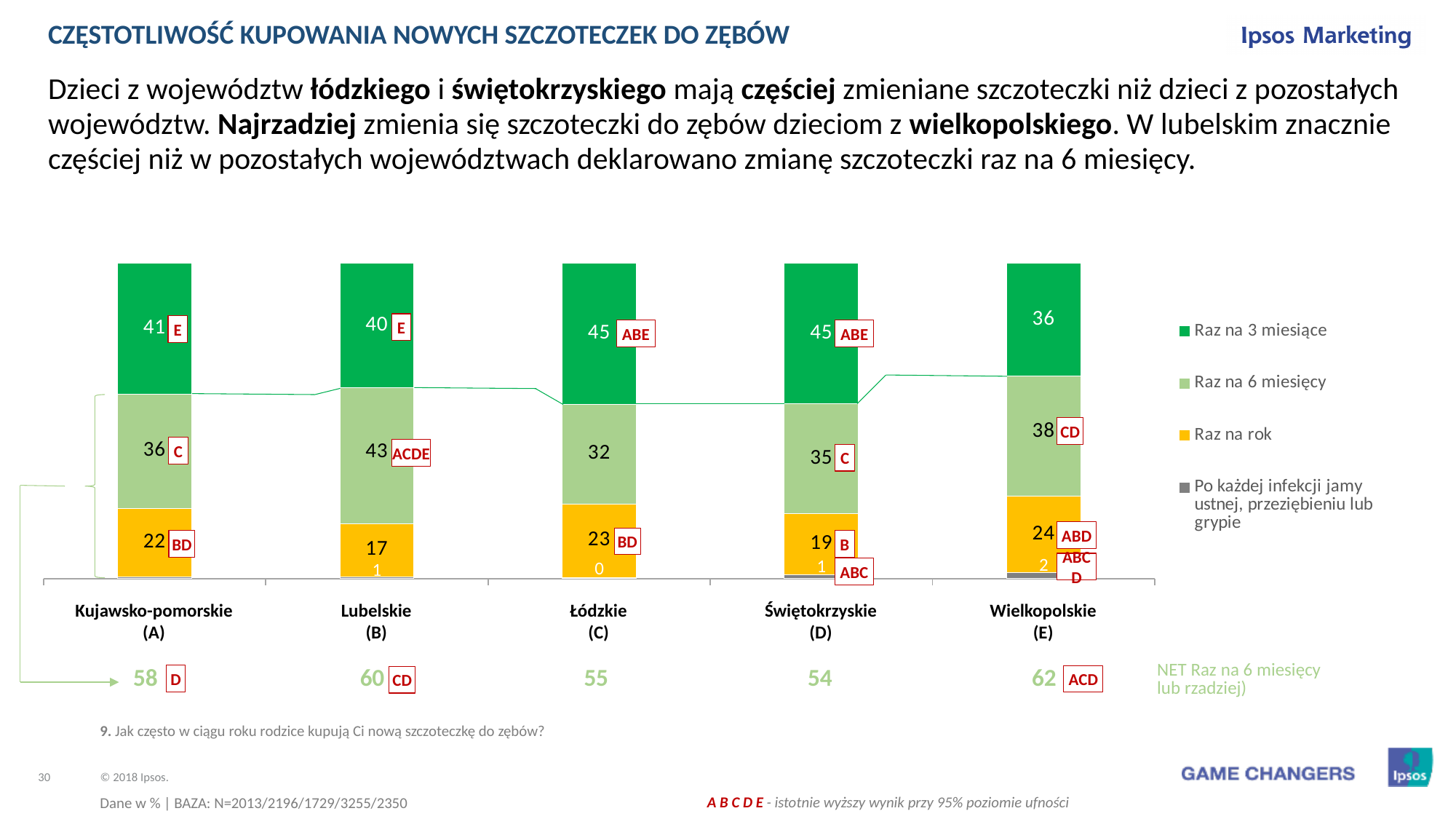
What is the value for "Raz na rok" for Świętokrzyskie (D)? 19 What is the value for "Raz na 3 miesiące" for Wielkopolskie (E)? 36 Which voivodeship has the lowest value for "Raz na 3 miesiące"? Wielkopolskie (E) What is the value for "Raz na 6 miesięcy" for Lubelskie (B)? 43 What is the "NET Raz na 6 miesięcy lub rzadziej" value for Wielkopolskie (E)? 62 How many series does the legend list? 4 What kind of chart is shown on the slide? Stacked bar chart Which is larger, the "Raz na rok" value for Kujawsko-pomorskie (A) or for Świętokrzyskie (D)? Kujawsko-pomorskie (A) Which colour represents "Raz na rok" in the legend? Yellow How many voivodeships are shown on the x axis of the chart? 5 What is the difference between the "Raz na 6 miesięcy" values for Lubelskie (B) and Łódzkie (C)? 11 Which voivodeship has the highest value for "Raz na 6 miesięcy"? Lubelskie (B)